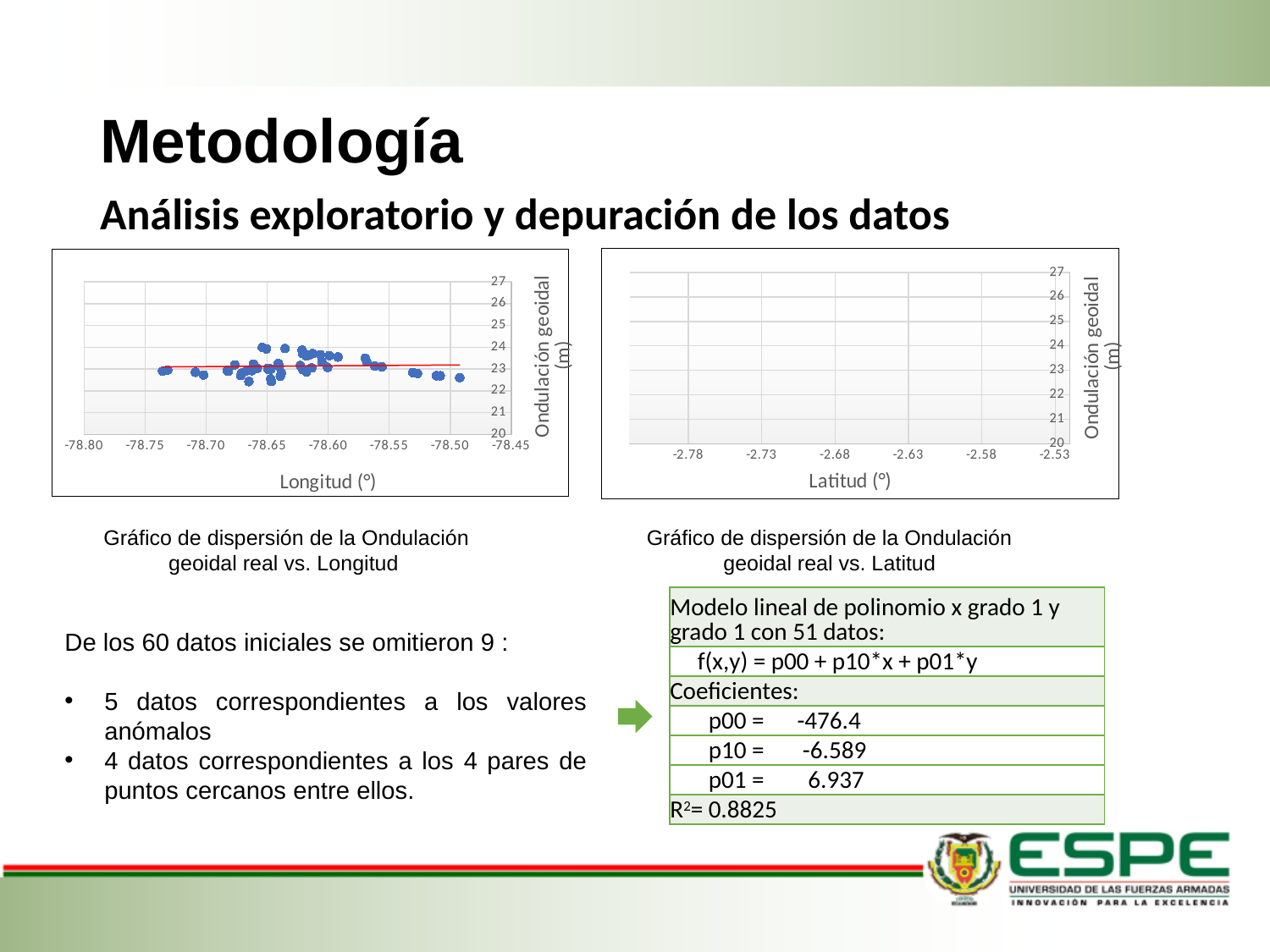
In the left chart, are the plotted Ondulación geoidal values greater or less than 22? greater What kind of chart is the right chart (Ondulación geoidal vs. Latitud)? scatter chart What is the x-axis title of the right chart? Latitud (°) In the left chart, are the plotted Ondulación geoidal values greater or less than 25? less What is the x-axis title of the left chart? Longitud (°) In the left chart, are the plotted Ondulación geoidal values greater or less than 20? greater What is the highest tick value on the y-axis of the left chart? 27 What kind of chart is the left chart (Ondulación geoidal vs. Longitud)? scatter chart